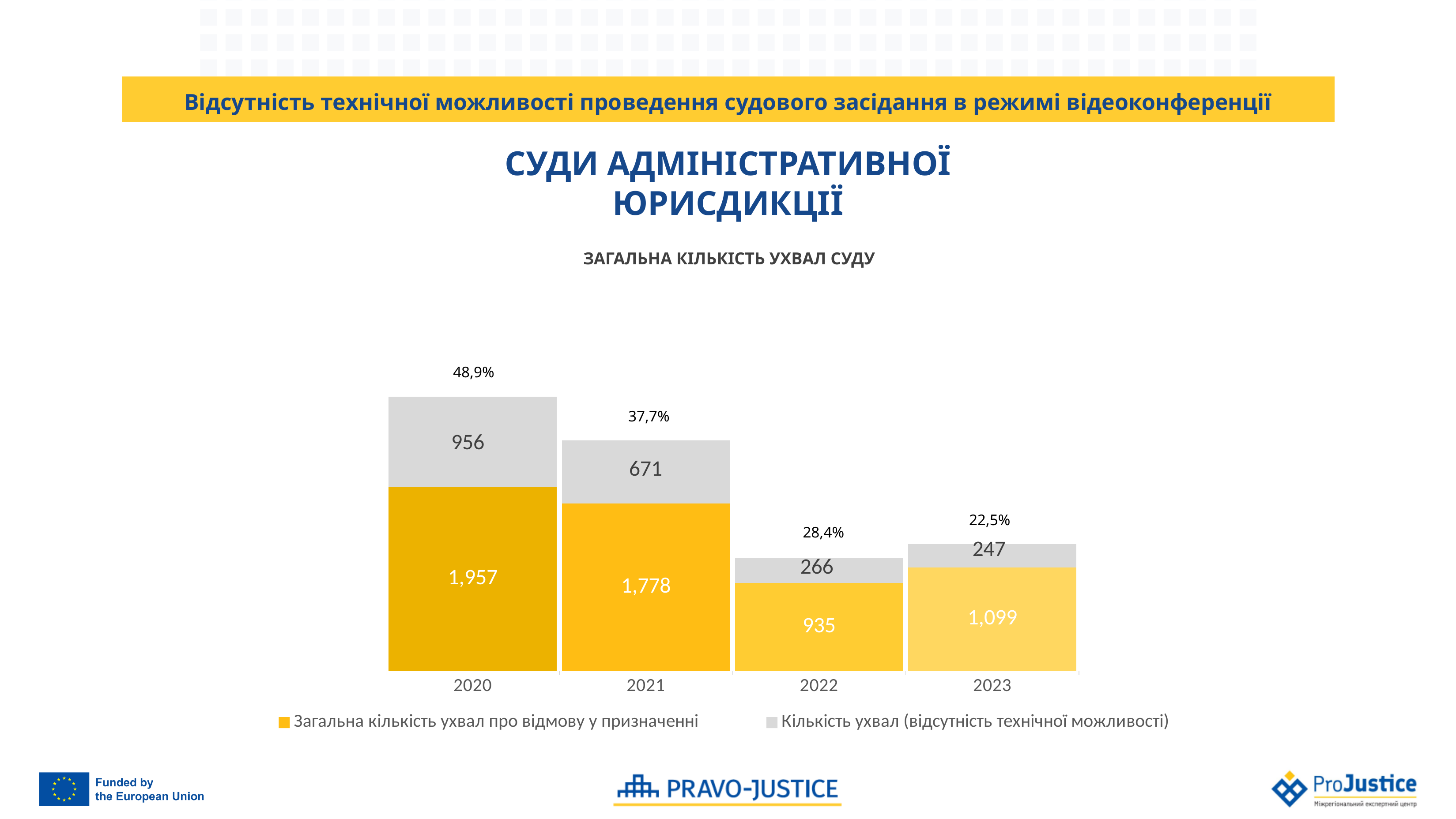
What is the total height of the stacked bar for 2022? 1,201 What percentage label is shown above the 2021 bar? 37,7% What is the difference between the 'Кількість ухвал (відсутність технічної можливості)' values for 2020 and 2021? 285 What is the total height of the stacked bar for 2020? 2,913 What is the value of the 'Загальна кількість ухвал про відмову у призначенні' series for 2020? 1,957 Which year has the larger 'Загальна кількість ухвал про відмову у призначенні' value, 2022 or 2023? 2023 What type of chart is shown on the slide? Stacked bar chart In which year is the 'Кількість ухвал (відсутність технічної можливості)' value the highest? 2020 In which year is the 'Загальна кількість ухвал про відмову у призначенні' value the lowest? 2022 How many series does the chart legend list? 2 How many years are shown on the x axis of the chart? 4 What is the value of the 'Кількість ухвал (відсутність технічної можливості)' series for 2022? 266